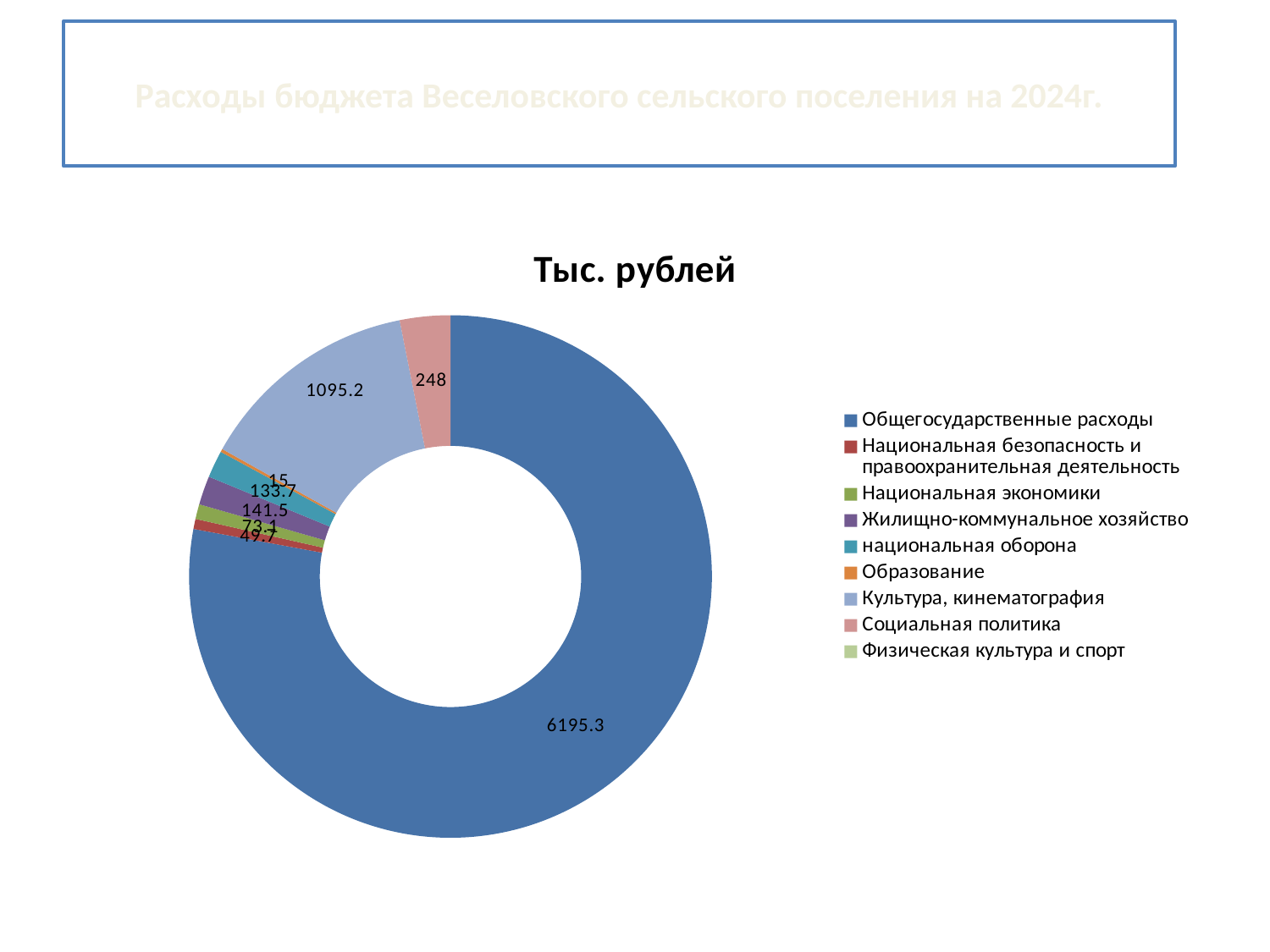
What is the value for Социальная политика? 248 Which is larger, Культура, кинематография or Социальная политика? Культура, кинематография What is the value for Образование? 15 What is the title of the chart? Тыс. рублей What kind of chart is shown on the slide? doughnut chart What is the value for Культура, кинематография? 1095.2 What is the value for Общегосударственные расходы? 6195.3 How many categories does the chart legend list? 9 What is the difference between the values for Культура, кинематография and Социальная политика? 847.2 What colour is the slice for Общегосударственные расходы? blue What is the value for Жилищно-коммунальное хозяйство? 141.5 Which category has the largest value? Общегосударственные расходы